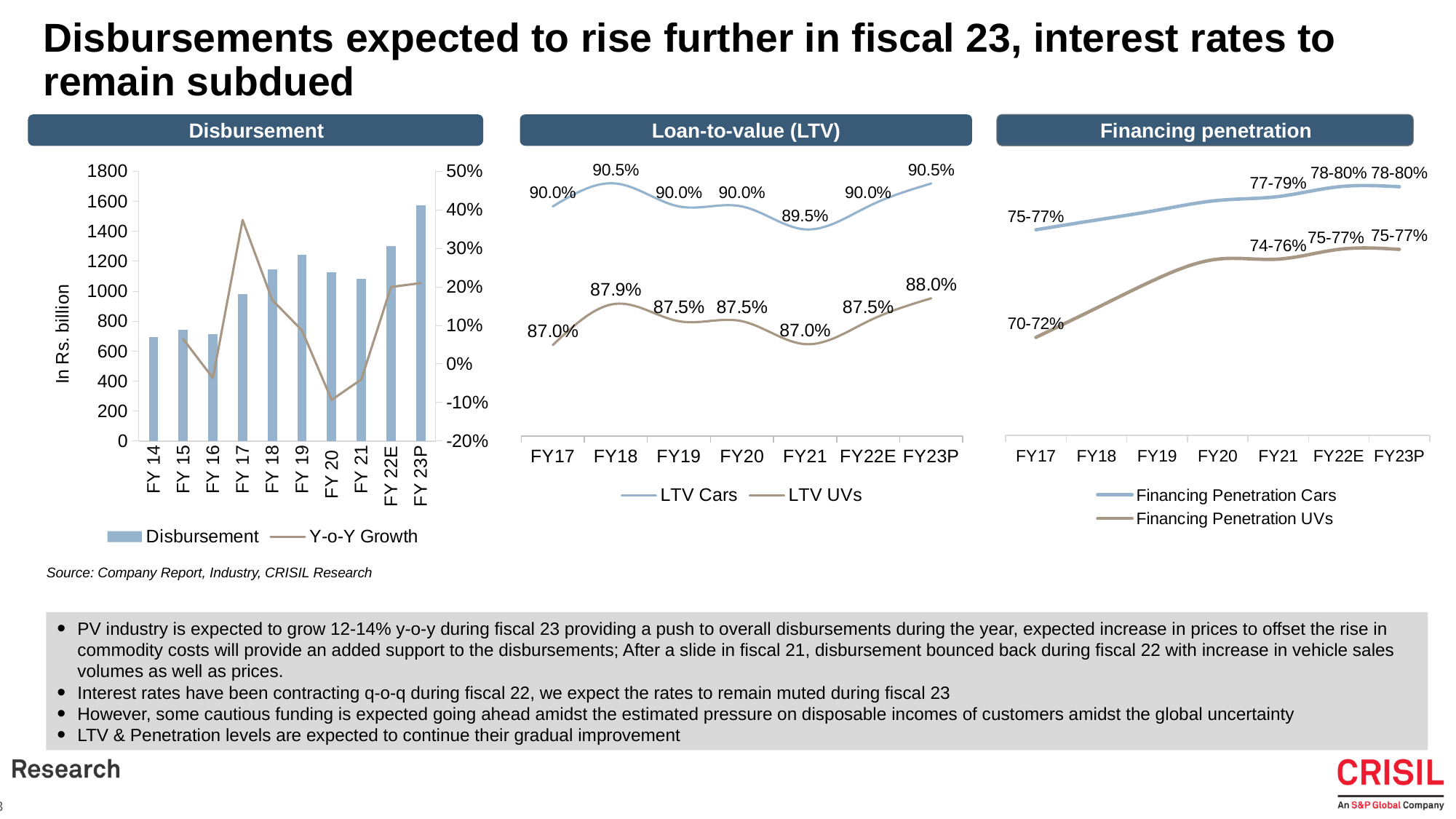
In the Disbursement chart, which year has the highest disbursement bar? FY 23P In the Disbursement chart, in which year does the Y-o-Y Growth line peak? FY 17 In the Loan-to-value (LTV) chart, in which year is the LTV for UVs lowest? FY17 and FY21 In the Loan-to-value (LTV) chart, what is the LTV for Cars in FY21? 89.5% In the Loan-to-value (LTV) chart, what is the LTV for UVs in FY23P? 88.0% In the Financing penetration chart, what is the financing penetration for Cars in FY23P? 78-80% In the Financing penetration chart, does financing penetration for UVs rise or fall from FY17 to FY23P? rise In the Disbursement chart, is the disbursement for FY 23P greater or less than 1400? greater In the Loan-to-value (LTV) chart, what is the difference between LTV Cars and LTV UVs in FY17? 3.0% In the Loan-to-value (LTV) chart, what is the LTV for UVs in FY18? 87.9% How many series does the legend of the Financing penetration chart list? 2 In the Financing penetration chart, what is the financing penetration for UVs in FY17? 70-72%